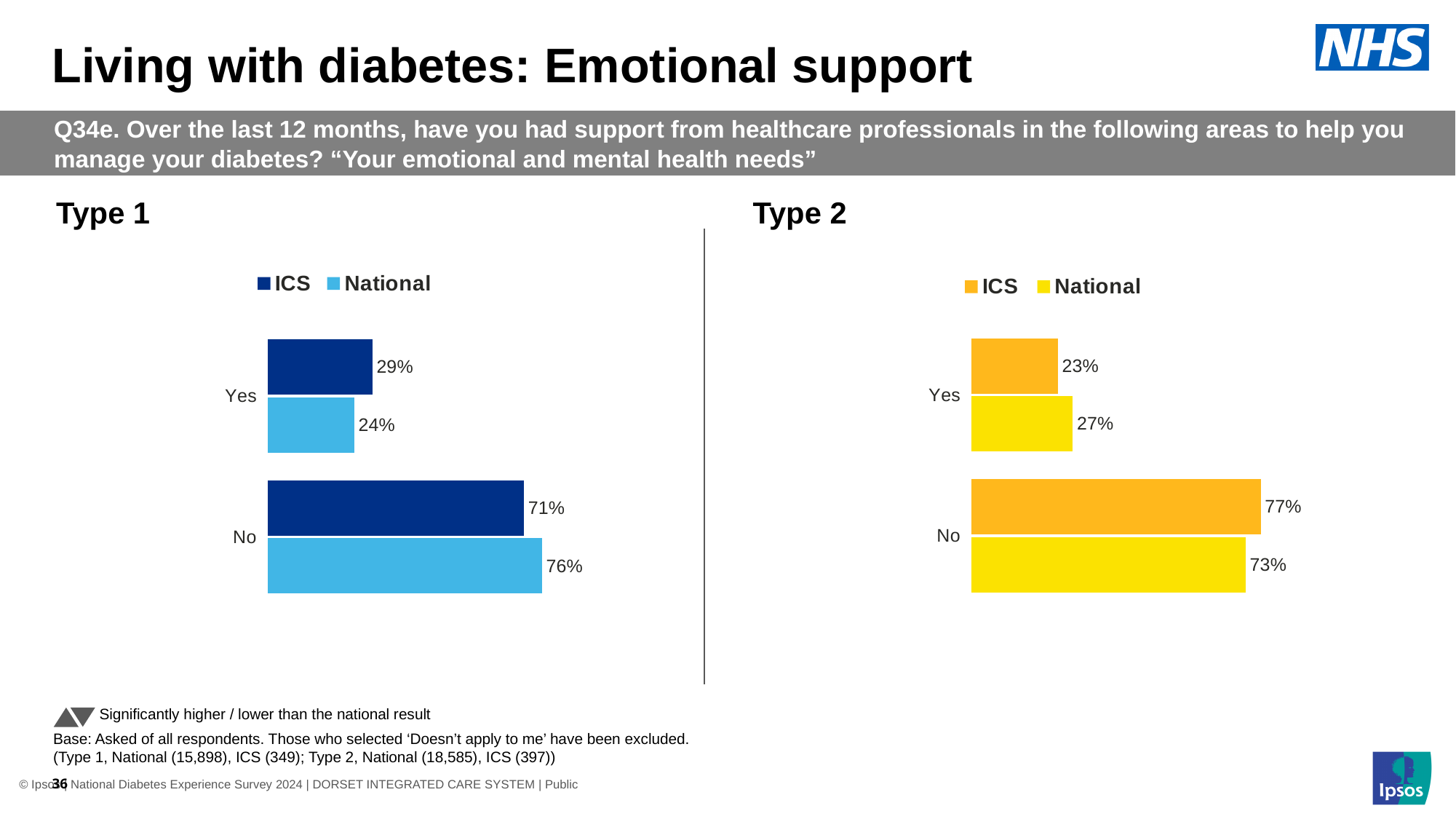
What kind of chart is the Type 1 chart? Bar chart In the Type 1 chart, which is larger for No, ICS or National? National In the Type 1 chart, what is the National value for No? 76% In the Type 2 chart, what is the National value for Yes? 27% In the Type 1 chart, what is the ICS value for Yes? 29% In the Type 2 chart, what is the ICS value for No? 77% In the Type 1 chart, what is the difference between the ICS and National values for Yes? 5 percentage points In the Type 2 chart, what colour represents the ICS series? Orange In the Type 2 chart, how many series does the legend list? 2 In the Type 1 chart, which category has the highest ICS value? No In the Type 2 chart, what is the difference between the ICS and National values for No? 4 percentage points In the Type 2 chart, which is larger for Yes, ICS or National? National